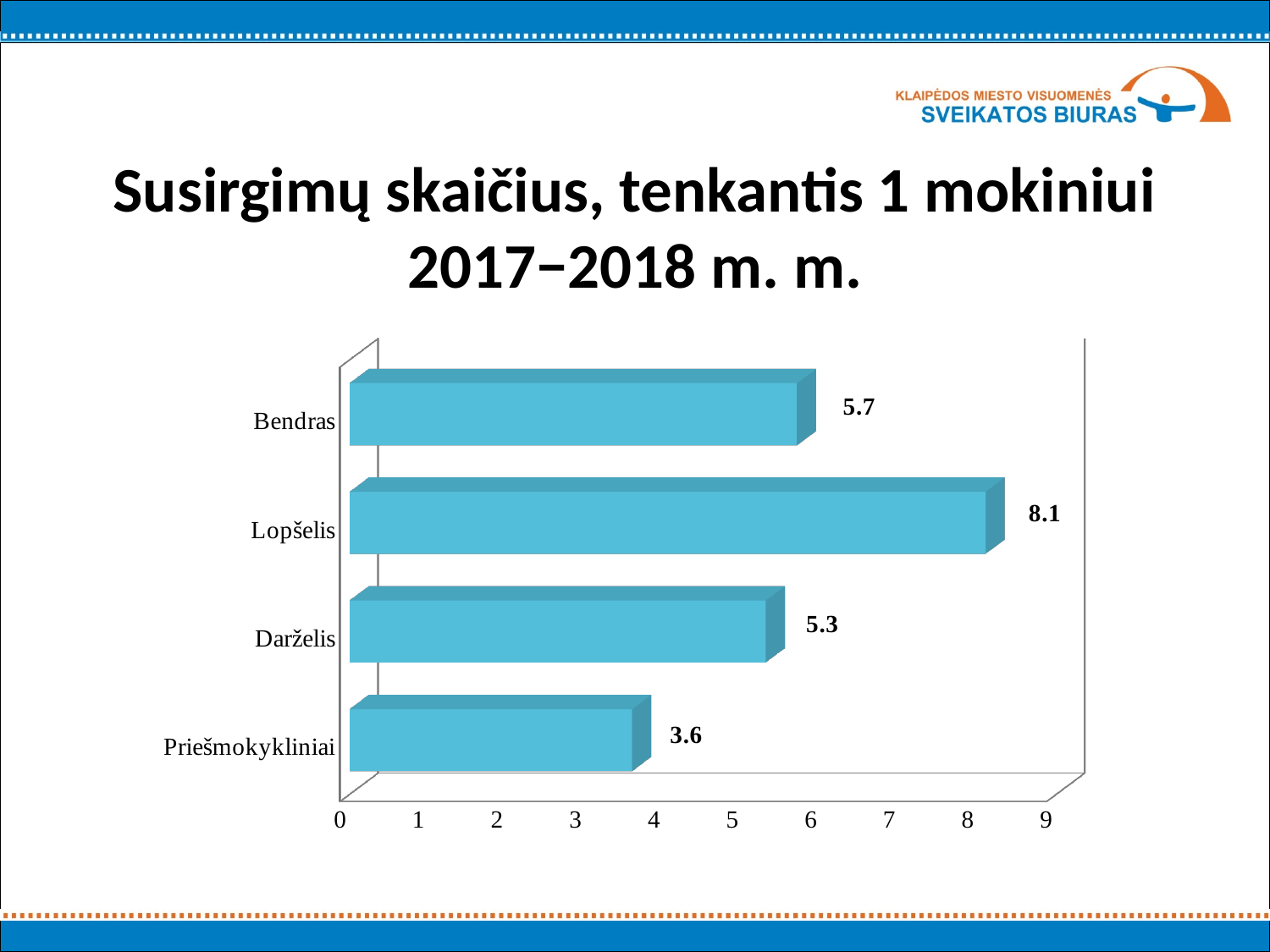
Is the value for Darželis greater or less than 4? greater How many categories are shown in the chart? 4 What is the value for Lopšelis? 8.1 What is the value for Bendras? 5.7 What is the value for Darželis? 5.3 What is the value for Priešmokykliniai? 3.6 Which category has the highest value? Lopšelis Which category has the lowest value? Priešmokykliniai What kind of chart is shown on the slide? Bar chart Which is larger, the value for Lopšelis or the value for Bendras? Lopšelis What is the difference between the values for Lopšelis and Priešmokykliniai? 4.5 What is the difference between the values for Bendras and Darželis? 0.4